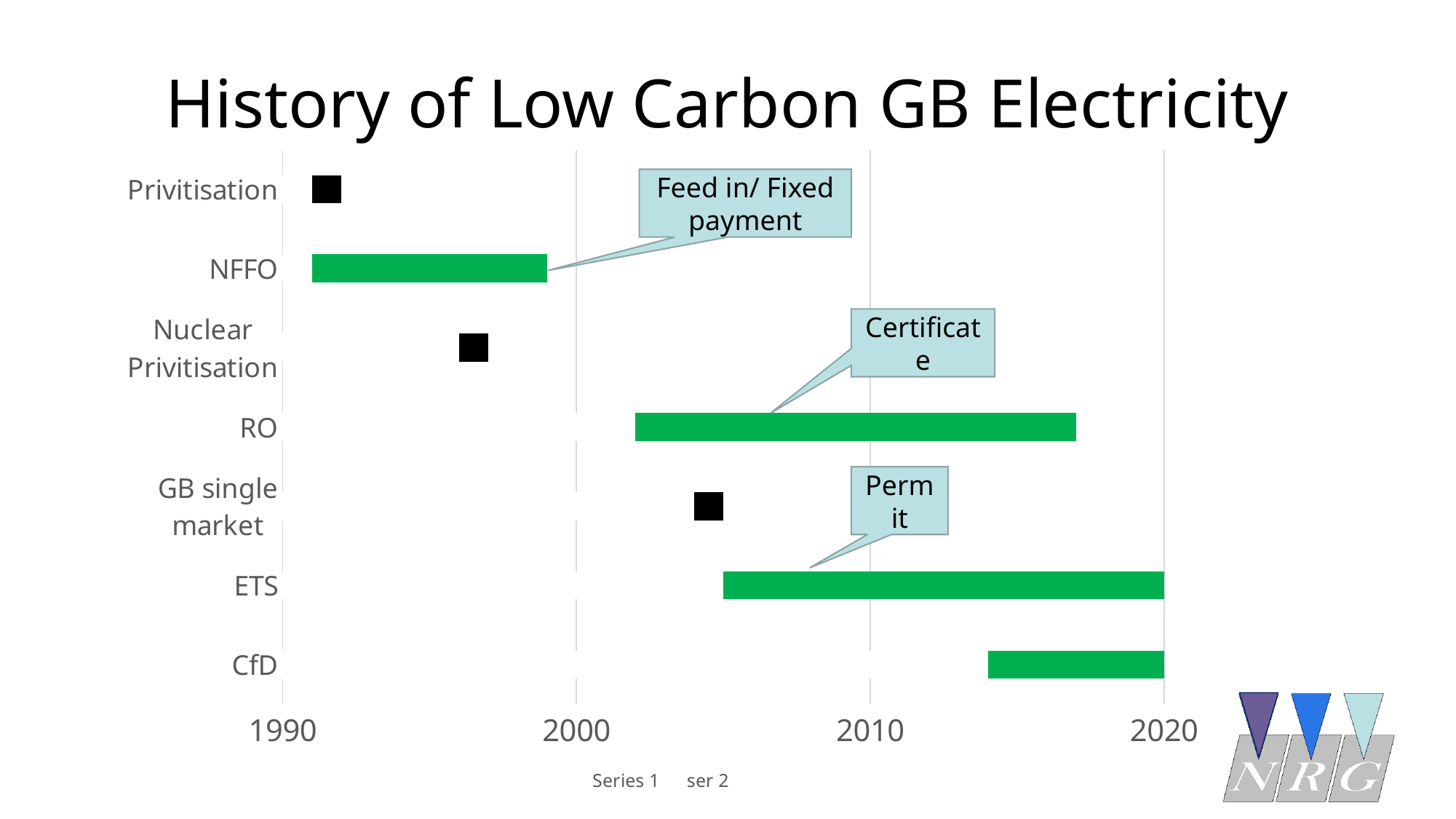
Which category does the 'Feed in/ Fixed payment' callout point to? NFFO Does the NFFO bar end before or after 2000? Before Does the CfD bar start before or after 2010? After Which category has the shortest green bar? CfD How many series does the legend list? 2 What type of chart is shown on the slide? Bar chart Does the RO bar start before or after 2000? After What is the title of the chart? History of Low Carbon GB Electricity Which green bar starts earliest on the time axis? NFFO Which bar is longer, NFFO or ETS? ETS How many categories are listed on the vertical axis of the chart? 7 In what year does the ETS bar end? 2020